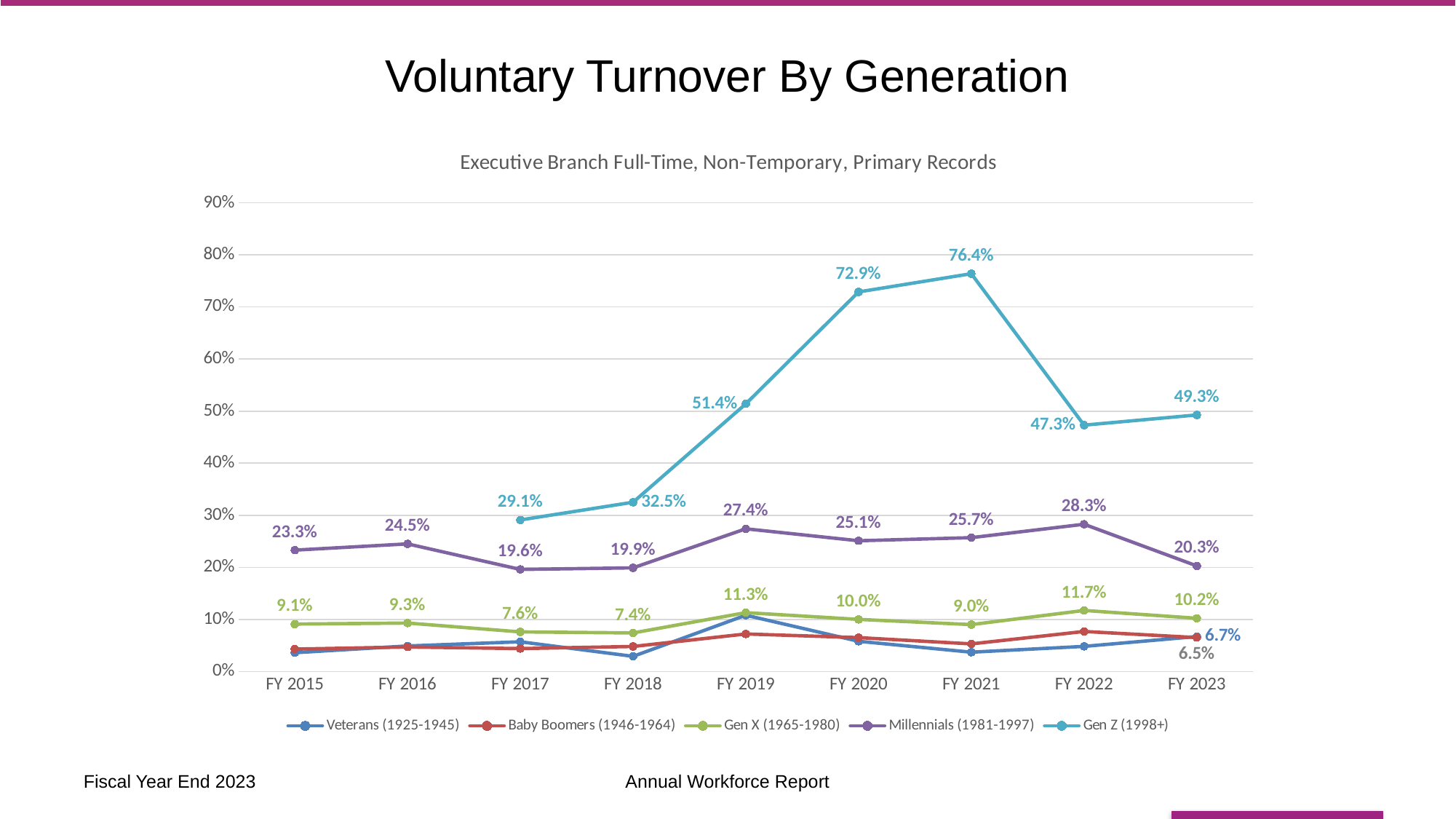
In which fiscal year is the Gen Z (1998+) turnover highest? FY 2021 What kind of chart is shown on the slide? Line chart In which fiscal year is the Gen X (1965-1980) turnover lowest? FY 2018 By how many percentage points did Gen Z (1998+) turnover fall from FY 2021 to FY 2022? 29.1 percentage points Does the Gen Z (1998+) line rise or fall from FY 2017 to FY 2021? Rise What is the voluntary turnover for Millennials (1981-1997) in FY 2019? 27.4% What is the voluntary turnover for Gen X (1965-1980) in FY 2022? 11.7% Which year has the higher Millennials (1981-1997) turnover, FY 2016 or FY 2017? FY 2016 Is the value for Veterans (1925-1945) in FY 2018 greater or less than 10%? less What is the voluntary turnover for Gen Z (1998+) in FY 2021? 76.4% How many series does the legend list? 5 How many fiscal years are shown on the x axis? 9